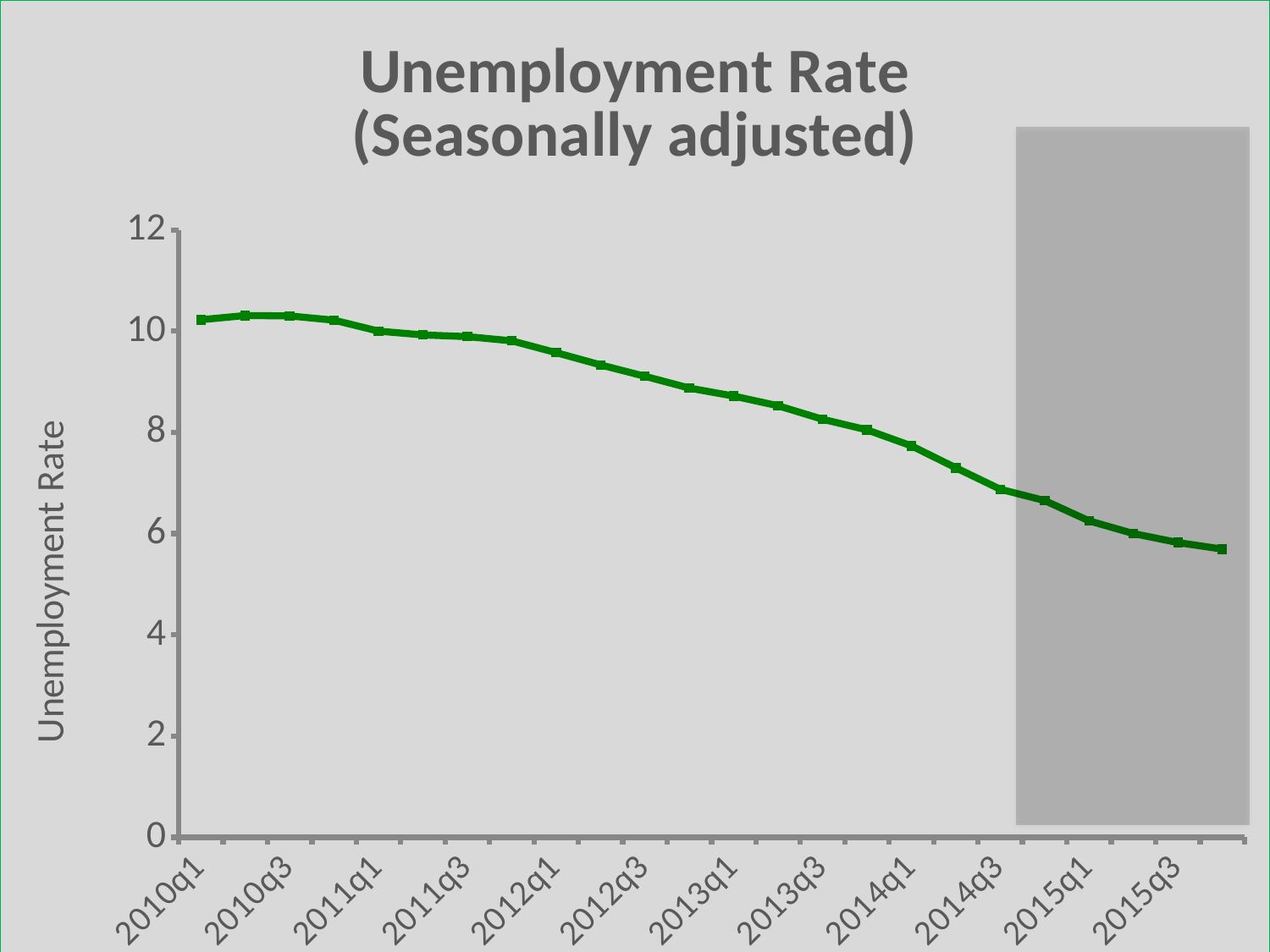
Is the value for 2014q3 greater or less than 6? greater What is the label on the vertical axis? Unemployment Rate Is the value for 2014q1 greater or less than 8? less Which has the higher unemployment rate, 2012q1 or 2014q1? 2012q1 Is the value for 2013q1 greater or less than 8? greater What is the title of the chart? Unemployment Rate (Seasonally adjusted) Which has the higher unemployment rate, 2010q1 or 2015q3? 2010q1 What kind of chart is shown on the slide? line chart Does the unemployment rate rise or fall from 2010q1 to 2015q3? fall How many quarter labels are shown on the x axis? 12